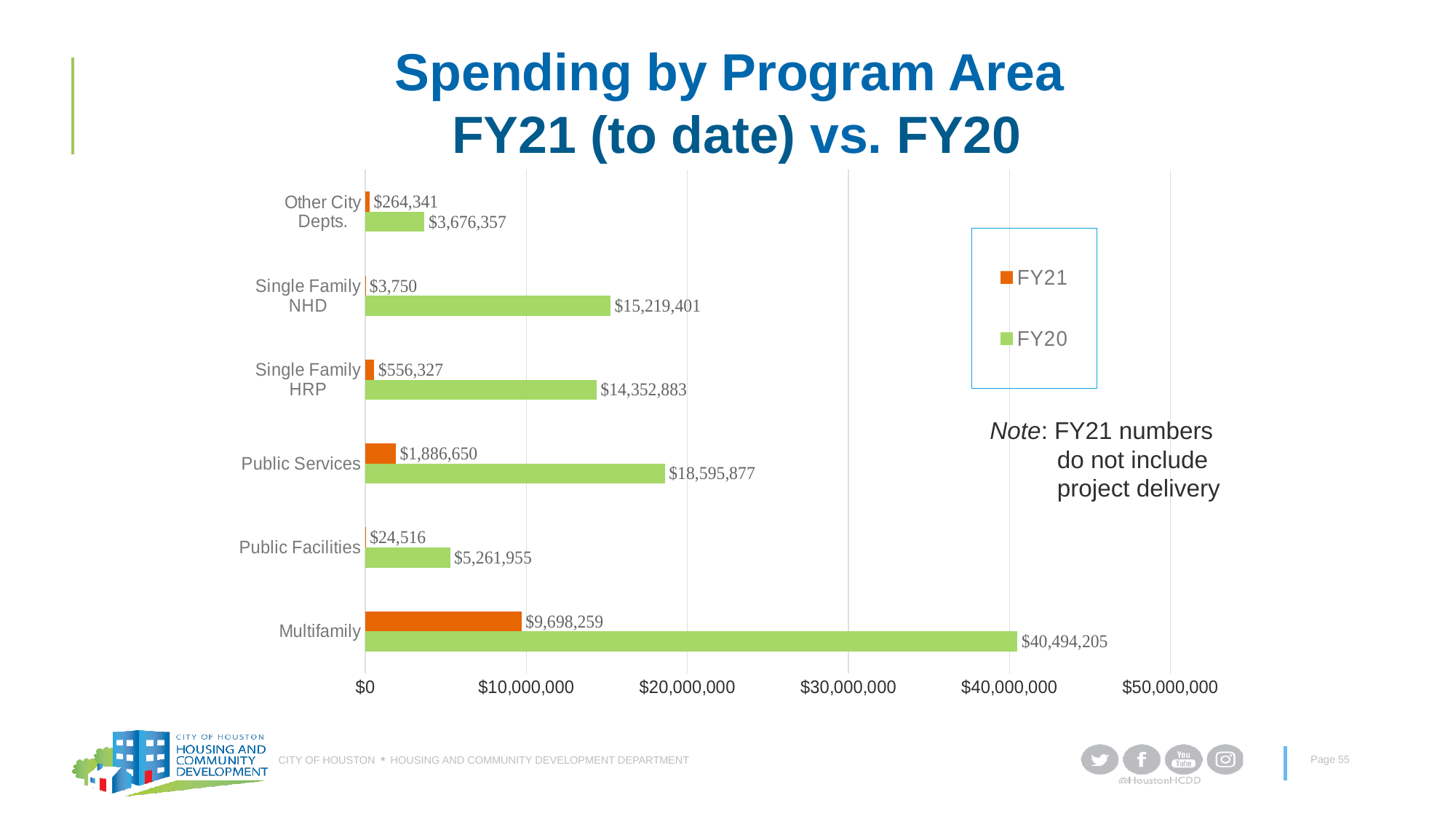
Which program area has the lowest FY21 spending? Single Family NHD Is the FY20 value for Public Services greater or less than $20,000,000? less How many series does the legend list? 2 Which is larger: FY20 spending for Single Family NHD or FY20 spending for Single Family HRP? Single Family NHD What is the FY21 spending for Public Services? $1,886,650 What is the difference between FY20 and FY21 spending for Multifamily? $30,795,946 Which program area has the highest FY20 spending? Multifamily What is the FY20 spending for Other City Depts.? $3,676,357 How many program areas are shown on the chart? 6 What is the FY20 spending for Multifamily? $40,494,205 What is the FY21 spending for Single Family NHD? $3,750 What kind of chart is shown on the slide? bar chart